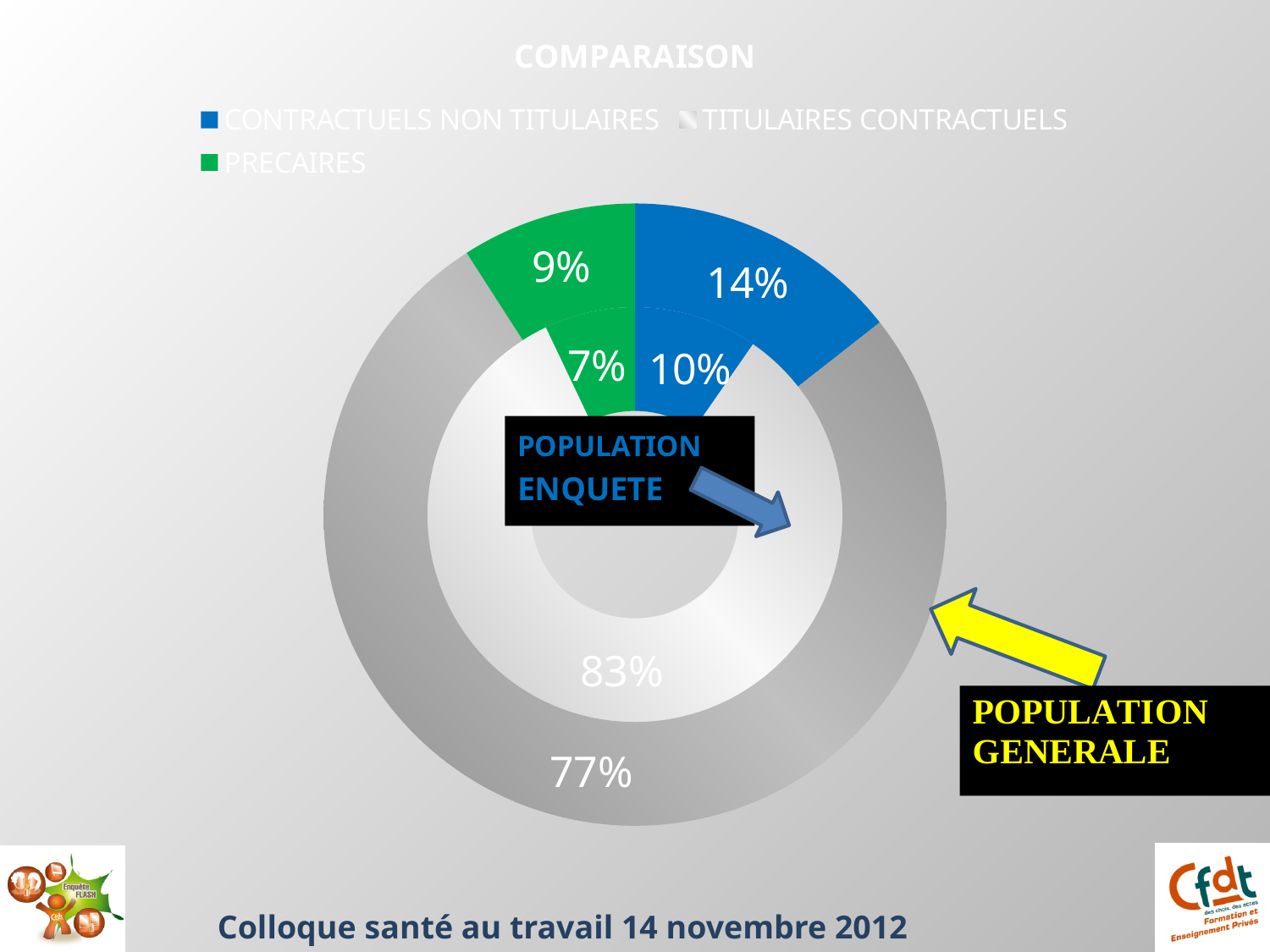
Which category has the largest share in the POPULATION GENERALE ring? TITULAIRES CONTRACTUELS What is the title of the chart? COMPARAISON Which category has the smallest share in the POPULATION ENQUETE ring? PRECAIRES What is the difference between the CONTRACTUELS NON TITULAIRES share in the POPULATION GENERALE ring and in the POPULATION ENQUETE ring? 4% In the outer ring (POPULATION GENERALE), what is the share for TITULAIRES CONTRACTUELS? 77% In the outer ring (POPULATION GENERALE), what is the share for CONTRACTUELS NON TITULAIRES? 14% In the inner ring (POPULATION ENQUETE), what is the share for TITULAIRES CONTRACTUELS? 83% In the outer ring (POPULATION GENERALE), what is the share for PRECAIRES? 9% What kind of chart is shown on the slide? doughnut chart In the inner ring (POPULATION ENQUETE), what is the share for PRECAIRES? 7% How many series does the legend list? 3 In the inner ring (POPULATION ENQUETE), what is the share for CONTRACTUELS NON TITULAIRES? 10%